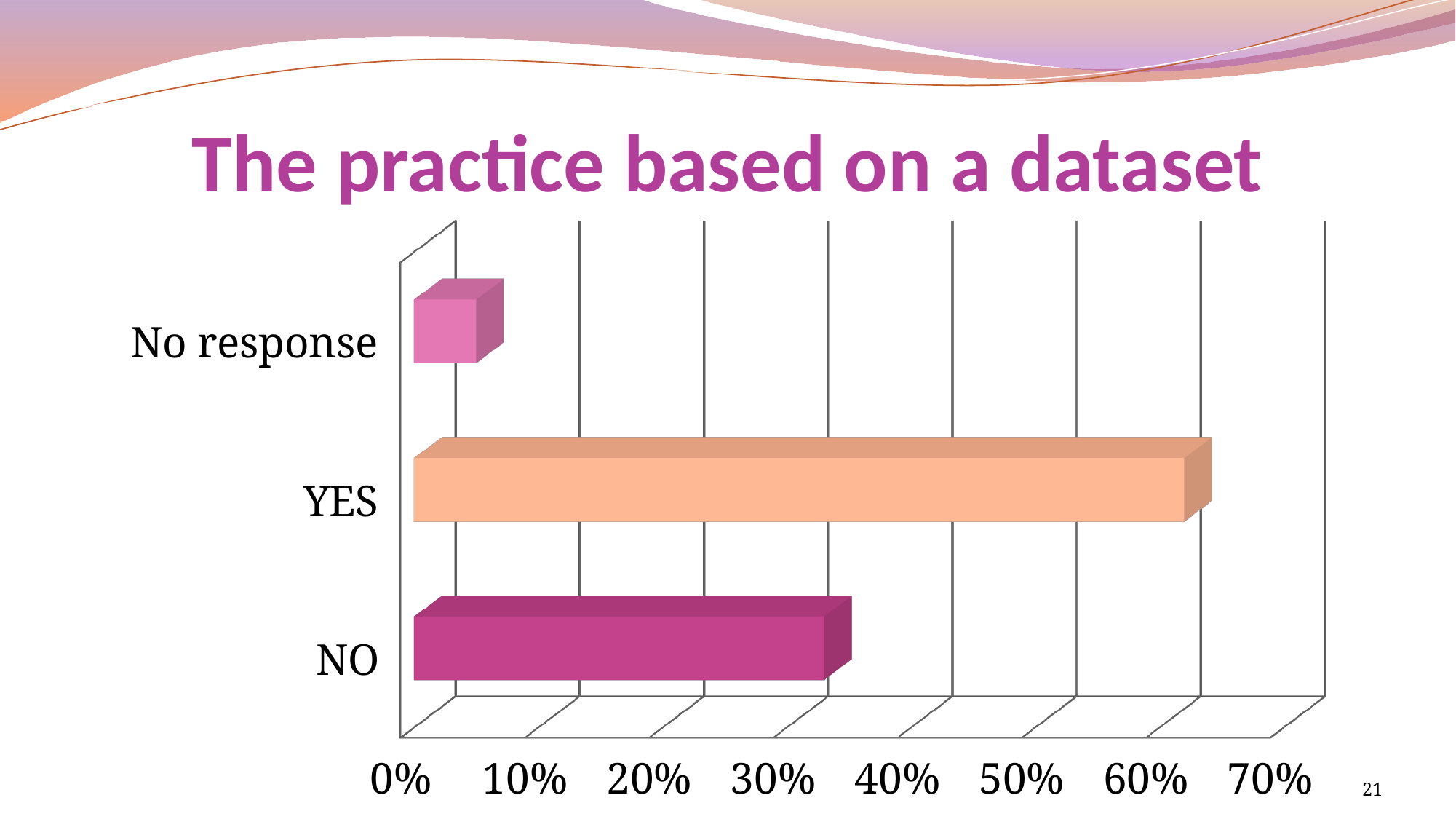
How many categories are shown in the chart? 3 Is the value for YES greater or less than 50%? greater Is the value for No response greater or less than 10%? less What is the title of the chart? The practice based on a dataset Which category has the highest value? YES Which category has the lowest value? No response Is the value for NO greater or less than 40%? less Which is larger, the value for NO or the value for No response? NO What is the highest value shown on the horizontal axis? 70% Which is larger, the value for YES or the value for NO? YES What kind of chart is shown on the slide? bar chart